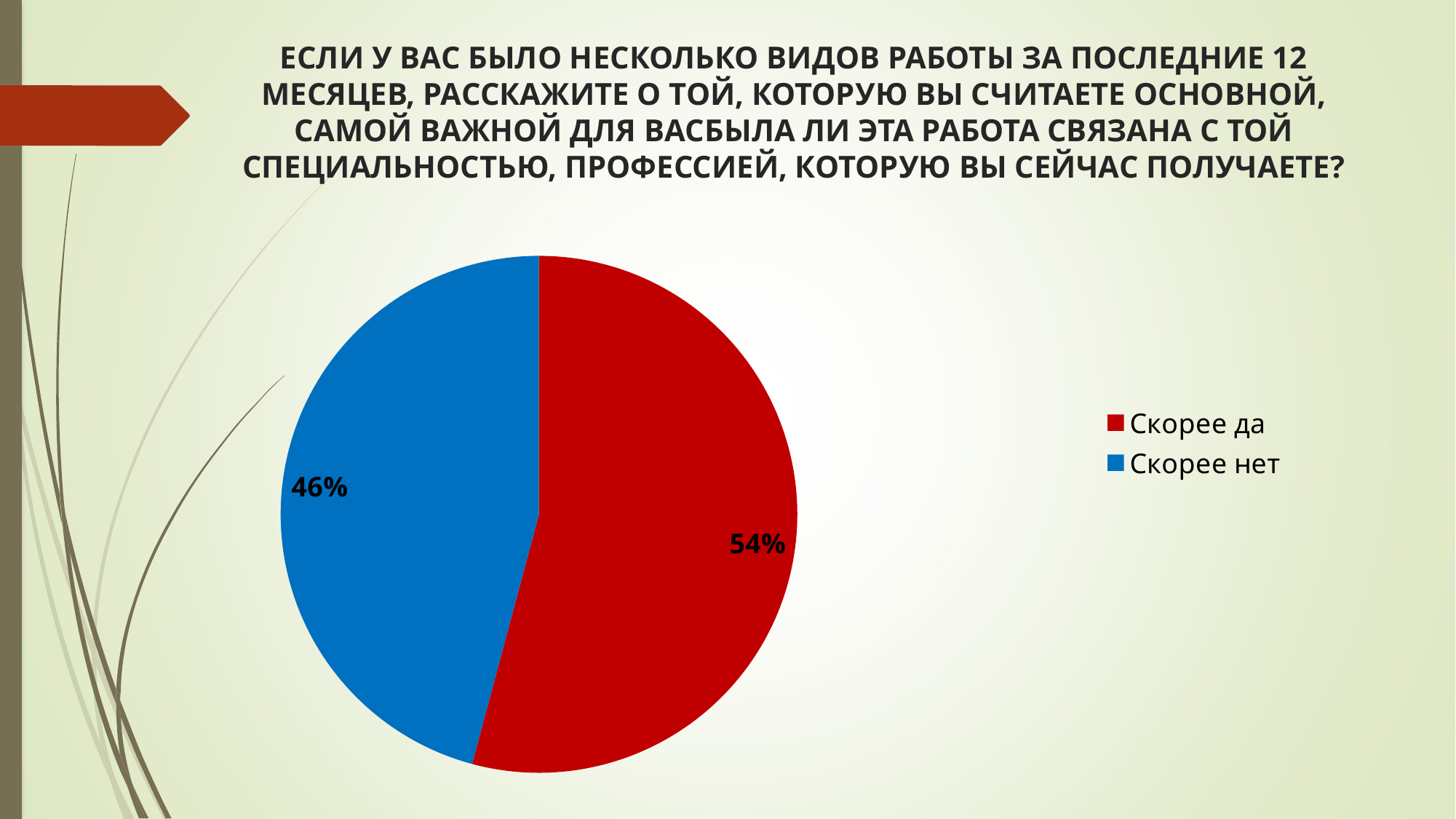
What kind of chart is shown on the slide? pie chart What percentage is shown for "Скорее нет"? 46% What percentage is shown for "Скорее да"? 54% Which is larger: the share for "Скорее да" or for "Скорее нет"? Скорее да Which category has the largest share of the pie? Скорее да How many entries does the legend list? 2 What share of the pie does "Скорее да" represent? 54% How many slices does the pie chart have? 2 What is the difference in percentage points between "Скорее да" and "Скорее нет"? 8 What colour is the slice for "Скорее нет"? blue What colour is the slice for "Скорее да"? red Which category has the smallest share of the pie? Скорее нет